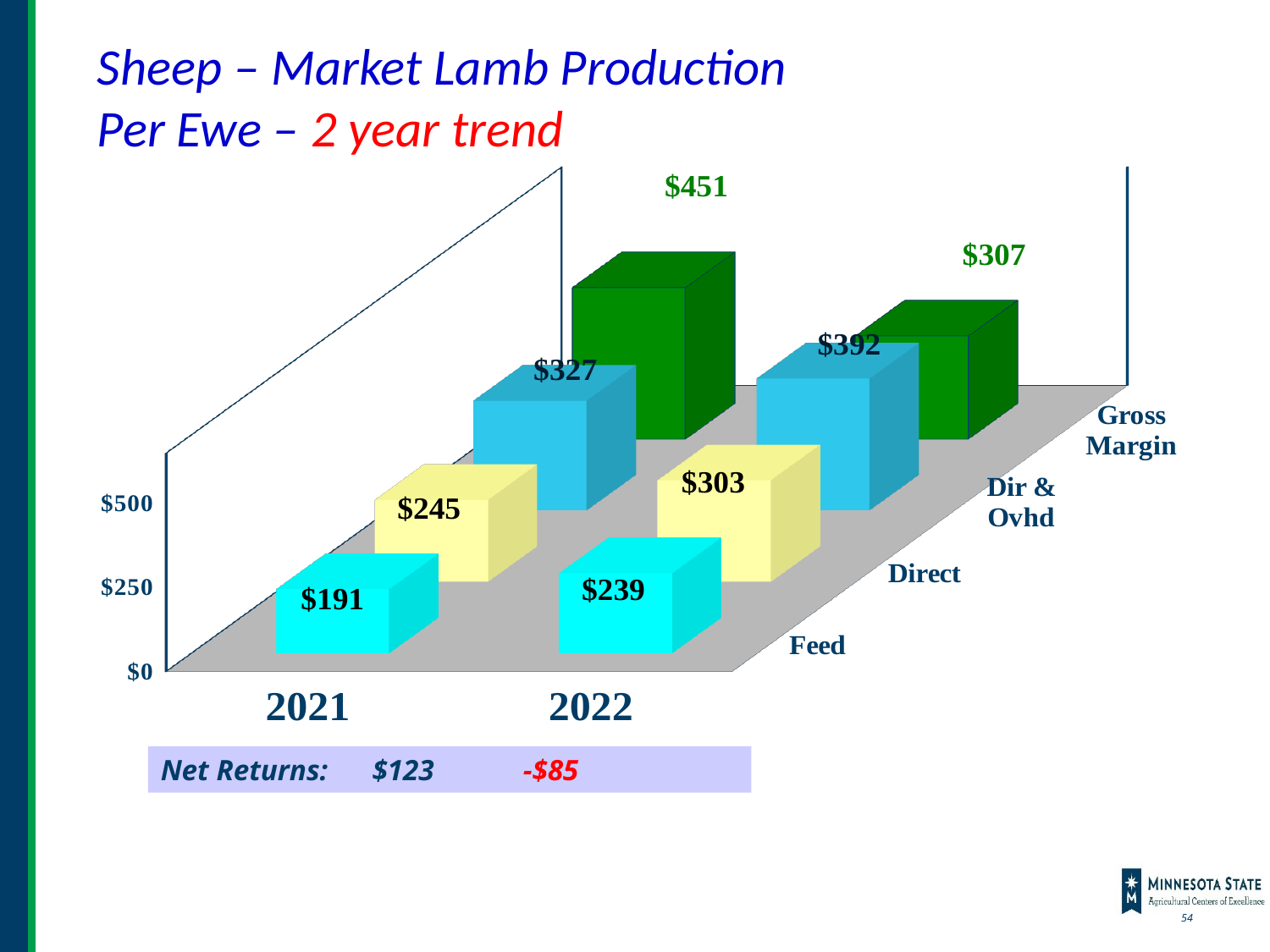
Which series has the lowest value in 2022? Feed What is the Gross Margin value for 2022? $307 What is the difference between the Gross Margin values for 2021 and 2022? $144 Which series has the highest value in 2021? Gross Margin What kind of chart is shown on the slide? Bar chart Does the Gross Margin value rise or fall from 2021 to 2022? Fall How many years are shown on the x axis? 2 What is the Direct value for 2021? $245 Which is larger, the Direct value for 2022 or the Dir & Ovhd value for 2021? Dir & Ovhd value for 2021 What is the Feed value for 2021? $191 What is the Dir & Ovhd value for 2022? $392 What is the difference between the Feed values for 2022 and 2021? $48